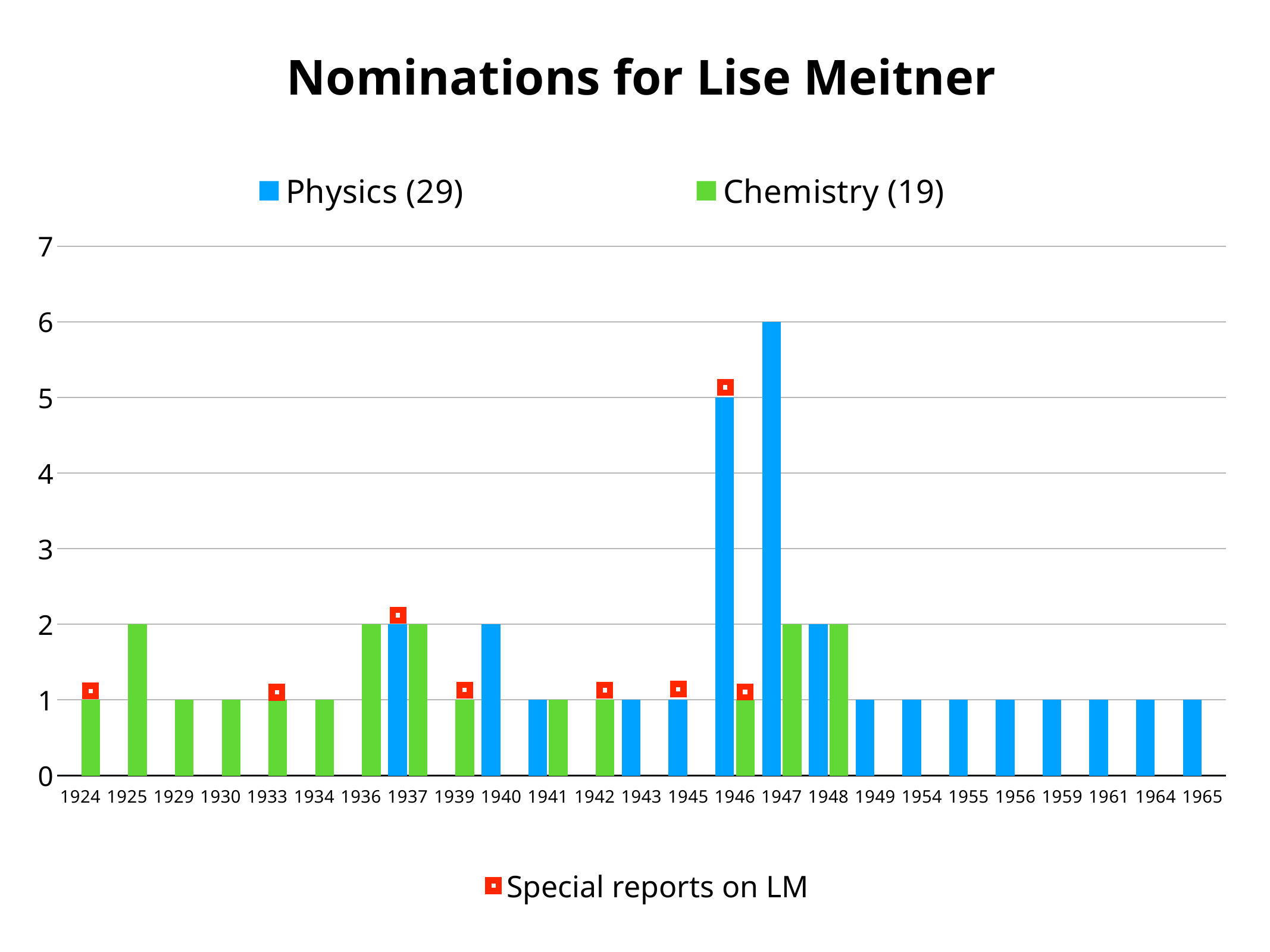
How many years are shown on the x axis of the chart? 25 What is the Physics value for 1947? 6 What is the title of the chart? Nominations for Lise Meitner In 1947, which is larger, the Physics value or the Chemistry value? Physics What does the red square marker in the bottom legend represent? Special reports on LM What is the difference between the Physics values for 1947 and 1946? 1 How many series does the top legend of the chart list? 2 Is the Physics value for 1946 greater or less than 4? greater What is the Chemistry value for 1925? 2 What kind of chart is shown on the slide? Bar chart What is the Physics value for 1946? 5 In which year is the Physics value highest? 1947